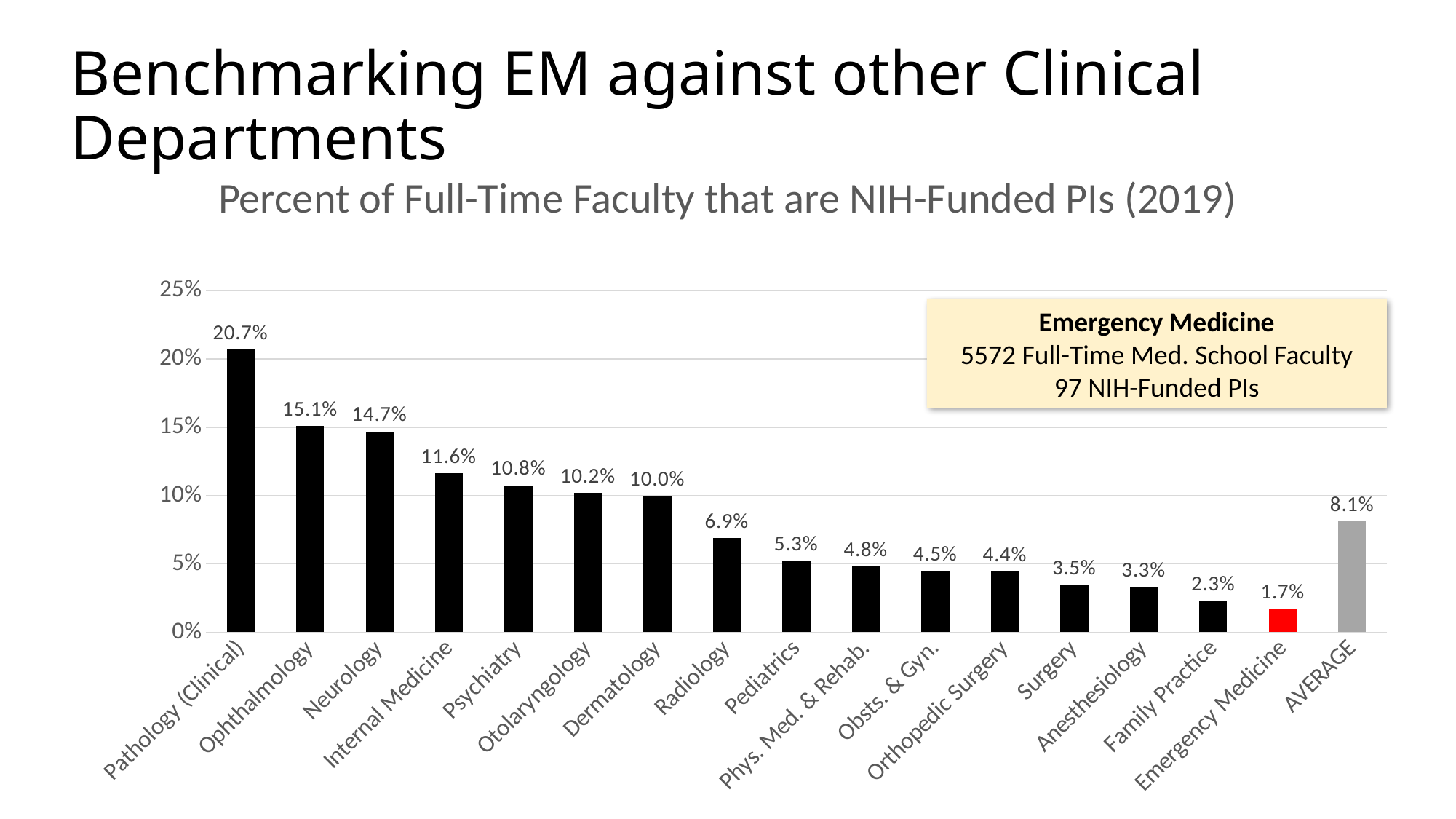
What is the title of the chart? Percent of Full-Time Faculty that are NIH-Funded PIs (2019) What is the difference between the AVERAGE value and the Emergency Medicine value? 6.4% What is the value shown for AVERAGE? 8.1% What kind of chart is shown on the slide? bar chart Is the value for Internal Medicine greater or less than 10%? greater What is the value for Emergency Medicine? 1.7% What is the value for Neurology? 14.7% Which has a larger value, Radiology or Pediatrics? Radiology What is the difference between the values for Pathology (Clinical) and Ophthalmology? 5.6% Which department has the highest percent of full-time faculty that are NIH-funded PIs? Pathology (Clinical) How many bars are plotted in the chart, including AVERAGE? 17 Which department has the lowest percent of full-time faculty that are NIH-funded PIs? Emergency Medicine